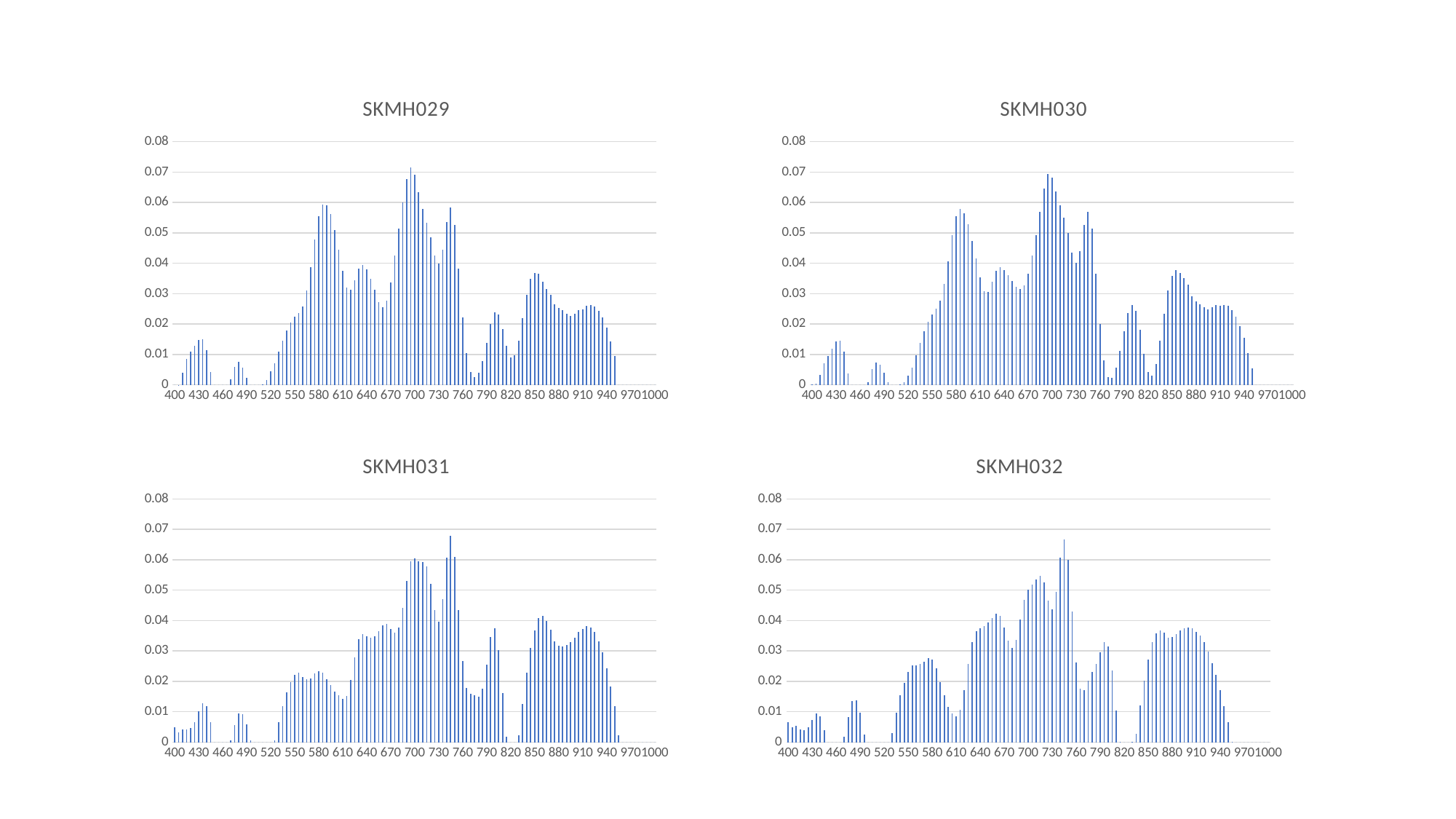
What kind of chart is SKMH029? bar chart How many charts are shown on the slide? 4 In the SKMH029 chart, is the value at 430 greater or less than 0.01? greater In the SKMH032 chart, is the value at 580 greater or less than 0.03? less In the SKMH030 chart, is the value at 700 greater or less than 0.06? greater What are the titles of the four charts on the slide? SKMH029, SKMH030, SKMH031, SKMH032 In the SKMH029 chart, which is larger: the value at 700 or the value at 850? 700 In the SKMH030 chart, which is larger: the value at 430 or the value at 580? 580 What is the maximum value shown on the vertical axis of the SKMH031 chart? 0.08